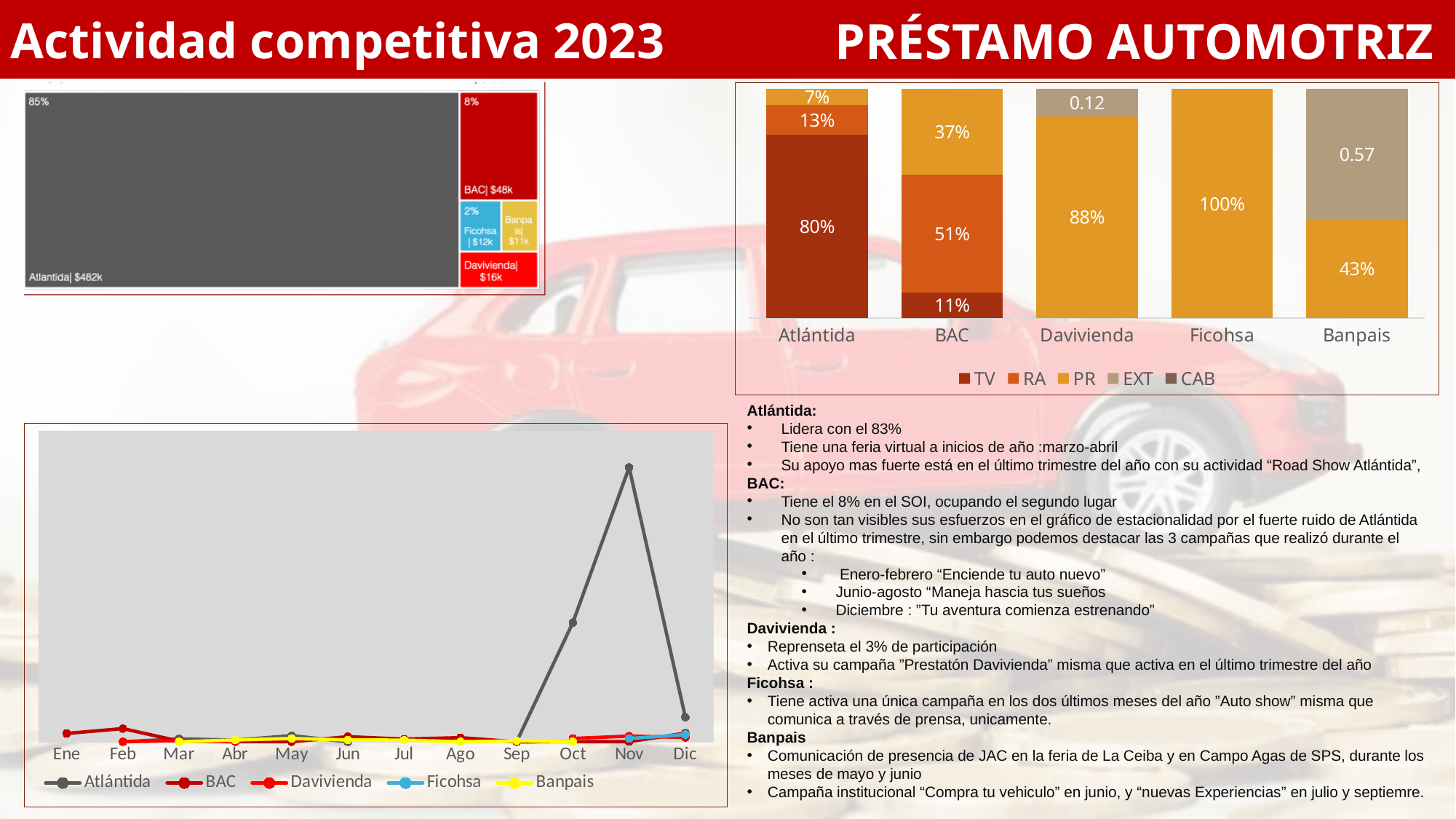
In the stacked bar chart on the top right, what is the TV share for Atlántida? 80% In the treemap on the top left, what amount is shown for BAC? $48k In the stacked bar chart on the top right, what is the difference between the PR share of Davivienda and the PR share of Banpais? 45% In the stacked bar chart on the top right, which is larger for BAC: the RA share or the PR share? RA What kind of chart is shown on the bottom left of the slide? Line chart In the stacked bar chart on the top right, what is the EXT value for Banpais? 0.57 In the treemap on the top left, what amount is shown for Atlantida? $482k In the stacked bar chart on the top right, what is the PR share for Ficohsa? 100% In the stacked bar chart on the top right, how many categories are shown on the x axis? 5 In the stacked bar chart on the top right, how many series does the legend list? 5 In the stacked bar chart on the top right, what is the RA share for BAC? 51% In the line chart on the bottom left, in which month does the Atlántida series reach its peak? Nov